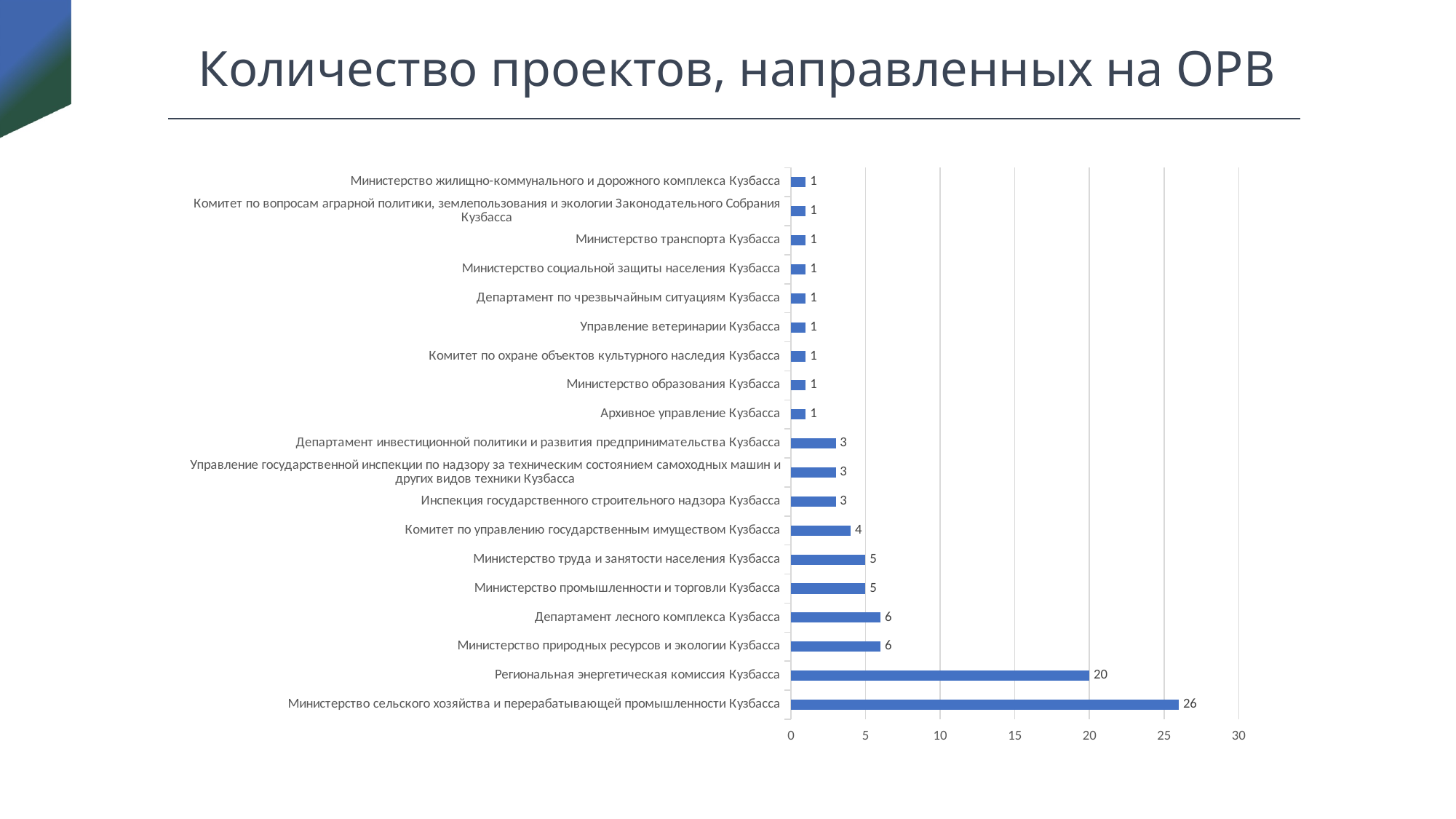
What is the value for Комитет по управлению государственным имуществом Кузбасса? 4 What is the value for Региональная энергетическая комиссия Кузбасса? 20 What is the difference between the values for Министерство сельского хозяйства и перерабатывающей промышленности Кузбасса and Региональная энергетическая комиссия Кузбасса? 6 What is the value for Департамент лесного комплекса Кузбасса? 6 How many categories have a value of 1? 9 Which is larger: the value for Министерство труда и занятости населения Кузбасса or the value for Инспекция государственного строительного надзора Кузбасса? Министерство труда и занятости населения Кузбасса What is the value for Министерство сельского хозяйства и перерабатывающей промышленности Кузбасса? 26 Is the value for Региональная энергетическая комиссия Кузбасса greater or less than 15? greater What is the title of the slide? Количество проектов, направленных на ОРВ What kind of chart is shown on the slide? bar chart How many categories are shown in the chart? 19 Which category has the highest value? Министерство сельского хозяйства и перерабатывающей промышленности Кузбасса